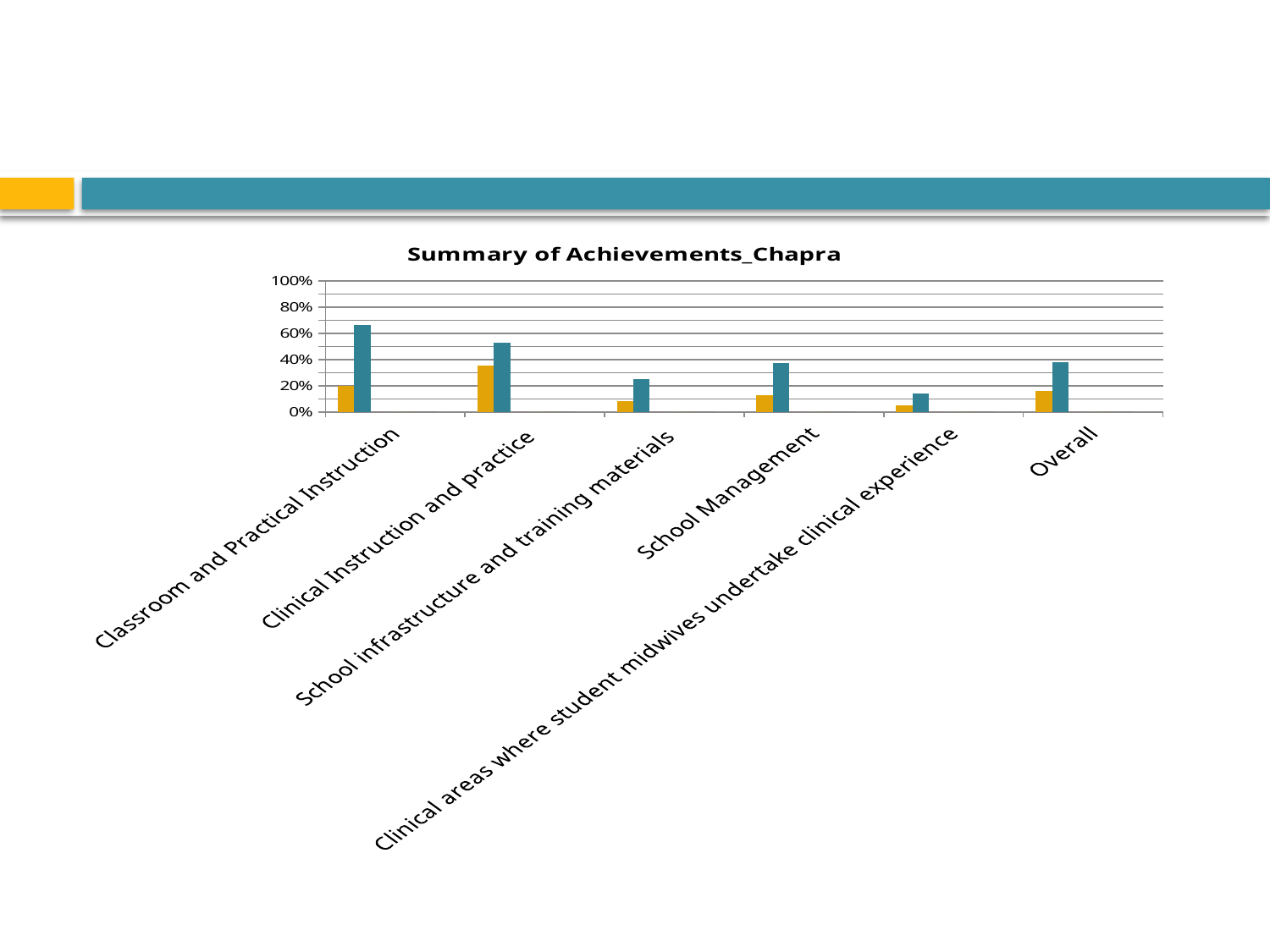
Is the orange bar for Clinical Instruction and practice greater or less than 20%? greater Which category has the tallest orange bar? Clinical Instruction and practice What is the title of the chart? Summary of Achievements_Chapra For Classroom and Practical Instruction, which bar is taller, the orange one or the teal one? The teal one What kind of chart is shown on the slide? Bar chart Which category has the shortest orange bar? Clinical areas where student midwives undertake clinical experience Which category has the tallest teal bar? Classroom and Practical Instruction How many categories are shown on the x axis of the chart? 6 Which category has the shortest teal bar? Clinical areas where student midwives undertake clinical experience How many series of bars are plotted for each category in the chart? 2 Is the teal bar for Clinical areas where student midwives undertake clinical experience greater or less than 20%? less Is the teal bar for Classroom and Practical Instruction greater or less than 60%? greater